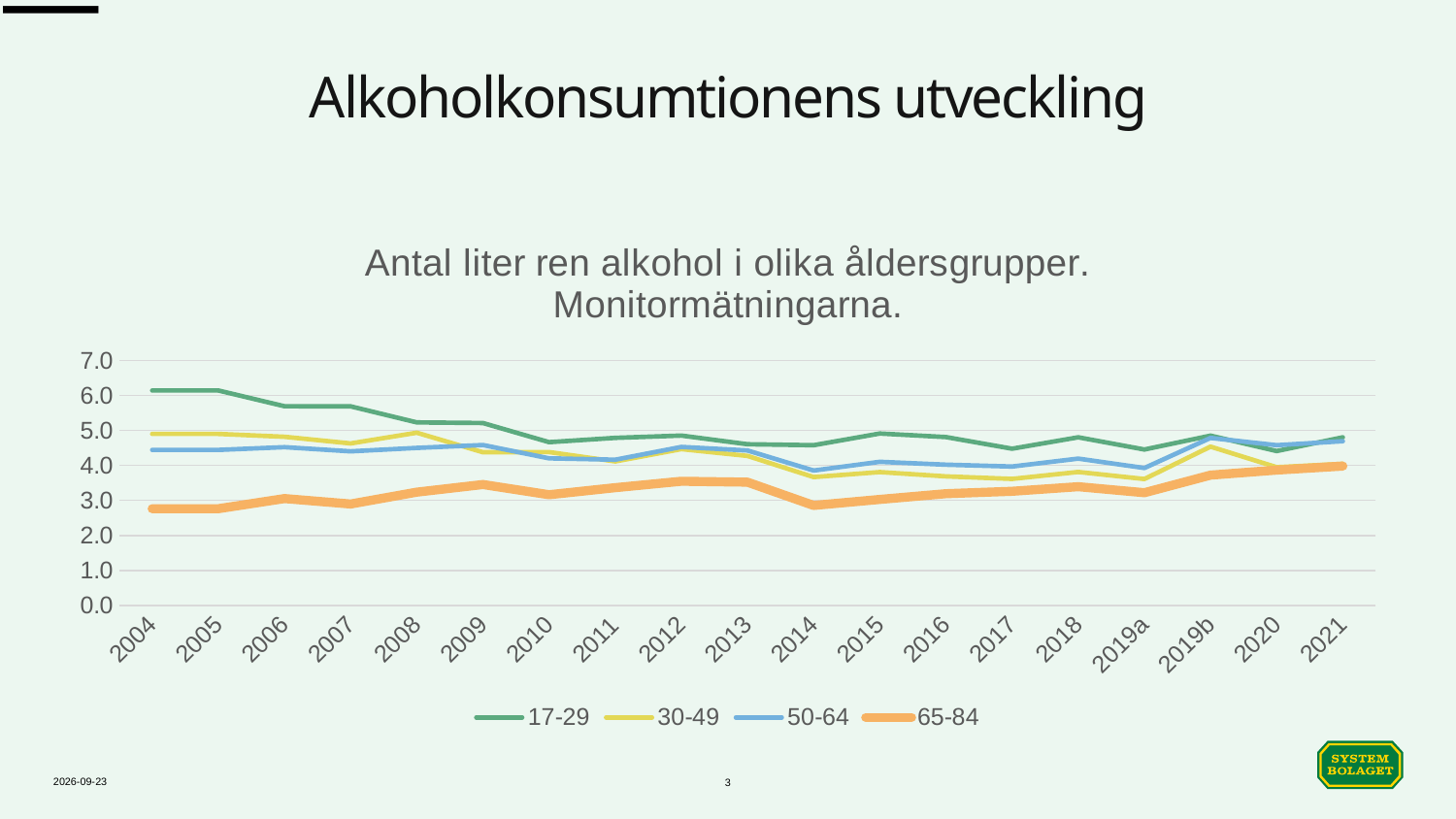
Is the value for the 30-49 group in 2019a greater or less than 4.0? less Which age group has the highest value in 2004? 17-29 How many series does the legend list? 4 Is the value for the 65-84 group in 2004 greater or less than 3.0? less Which is larger in 2021, the value for 17-29 or the value for 65-84? 17-29 What kind of chart is shown on the slide? Line chart Does the 17-29 line generally rise or fall from 2004 to 2021? fall How many points are there along the x axis? 19 Which age group has the lowest value in 2021? 65-84 Is the value for the 17-29 group in 2006 greater or less than 5.0? greater Which age group has the lowest value in 2004? 65-84 What is the title of the chart? Antal liter ren alkohol i olika åldersgrupper. Monitormätningarna.